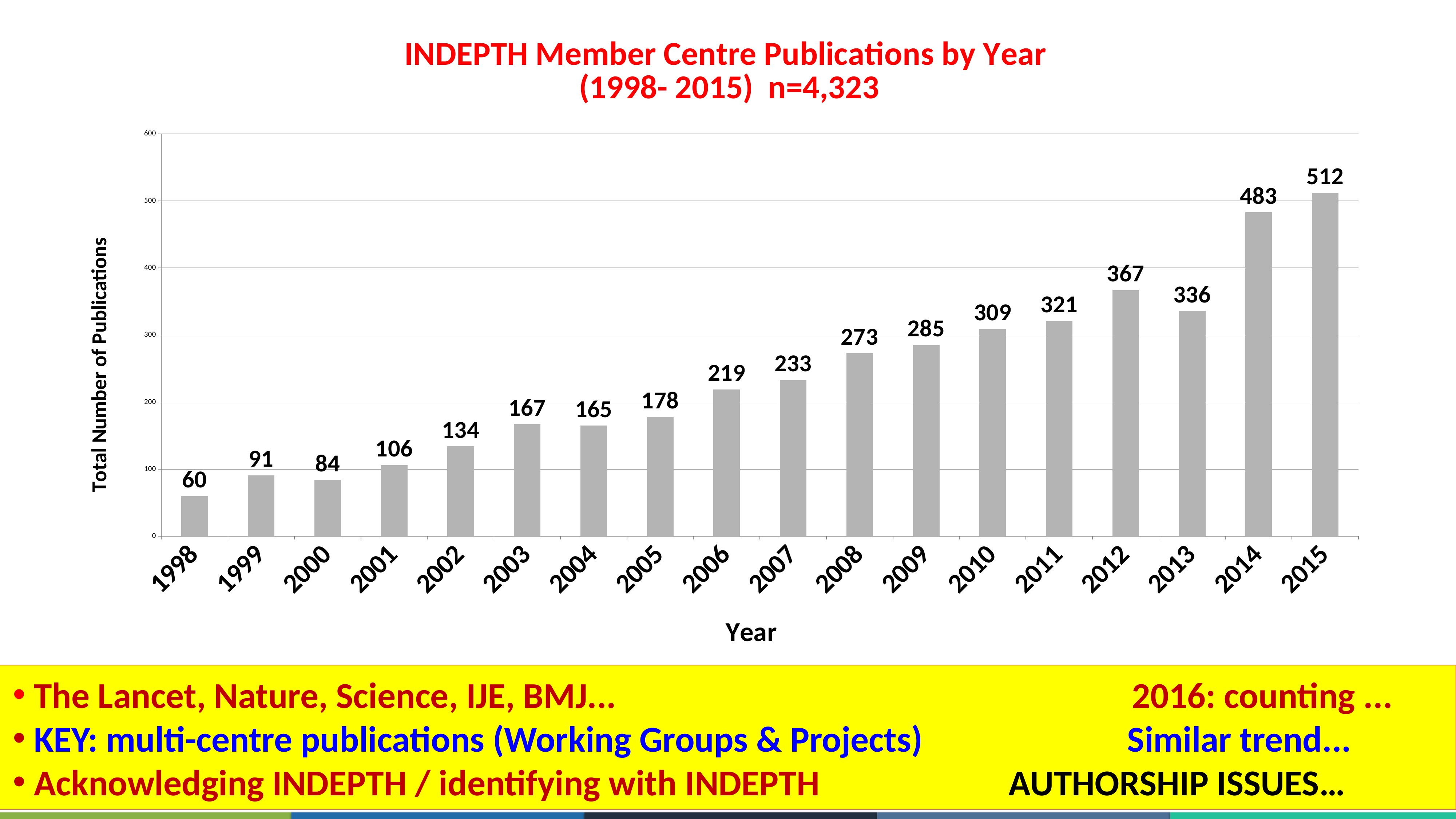
What is the total number of publications for 2010? 309 What is the total number of publications for 2013? 336 How many years are shown on the x axis? 18 Which year has the highest number of publications? 2015 What is the difference in publications between 2015 and 2014? 29 What is the title of the chart? INDEPTH Member Centre Publications by Year (1998- 2015) n=4,323 What is the difference in publications between 2012 and 2013? 31 What is the total number of publications for 1998? 60 Which year has the lowest number of publications? 1998 What kind of chart is shown on the slide? Bar chart Is the value for 2008 greater or less than 300? less Which year had more publications, 2003 or 2004? 2003